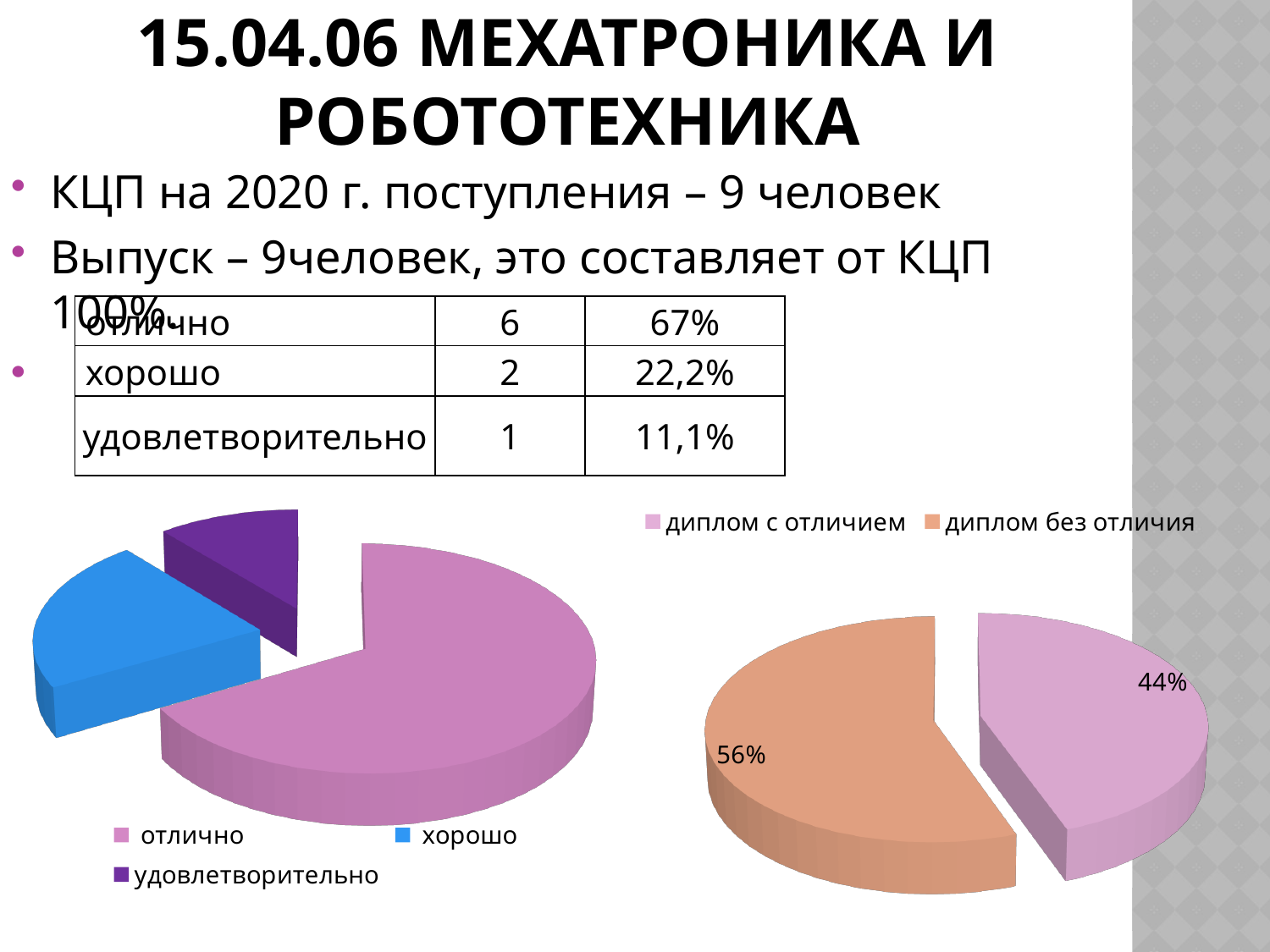
In the right pie chart, what is the share for диплом без отличия? 56% In the left pie chart, which slice is larger: хорошо or удовлетворительно? хорошо In the left pie chart, what colour is the отлично slice? pink What kind of chart is the left chart with the legend отлично, хорошо, удовлетворительно? pie chart In the left pie chart, which category has the smallest slice? удовлетворительно In the left pie chart, how many slices are there? 3 In the right pie chart, what is the difference between the shares of диплом без отличия and диплом с отличием? 12% In the right pie chart, how many slices are there? 2 In the left pie chart, which category has the largest slice? отлично In the right pie chart, which category has the larger slice? диплом без отличия How many entries does the legend of the right pie chart list? 2 In the right pie chart, what is the share for диплом с отличием? 44%